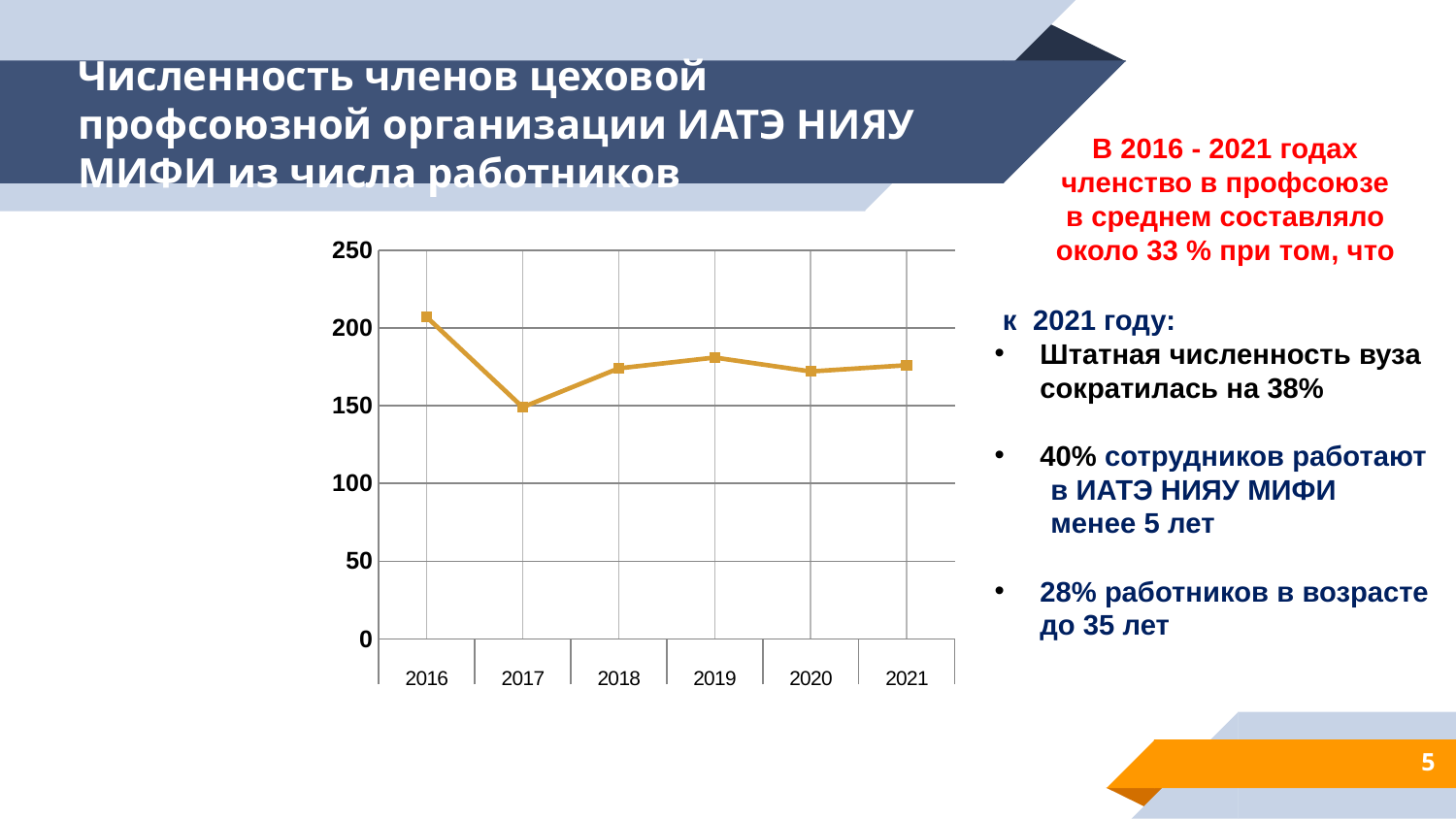
Is the value for 2016 greater or less than 200? greater What colour is the line on the chart? orange Is the value for 2019 greater or less than 150? greater How many years are plotted on the x axis of the chart? 6 Which year has the lowest value on the chart? 2017 Which is larger, the value for 2016 or the value for 2017? 2016 Which is larger, the value for 2017 or the value for 2018? 2018 Is the value for 2018 greater or less than 200? less Which year has the highest value on the chart? 2016 What kind of chart is shown on the slide? line chart Does the value rise or fall from 2016 to 2017? fall